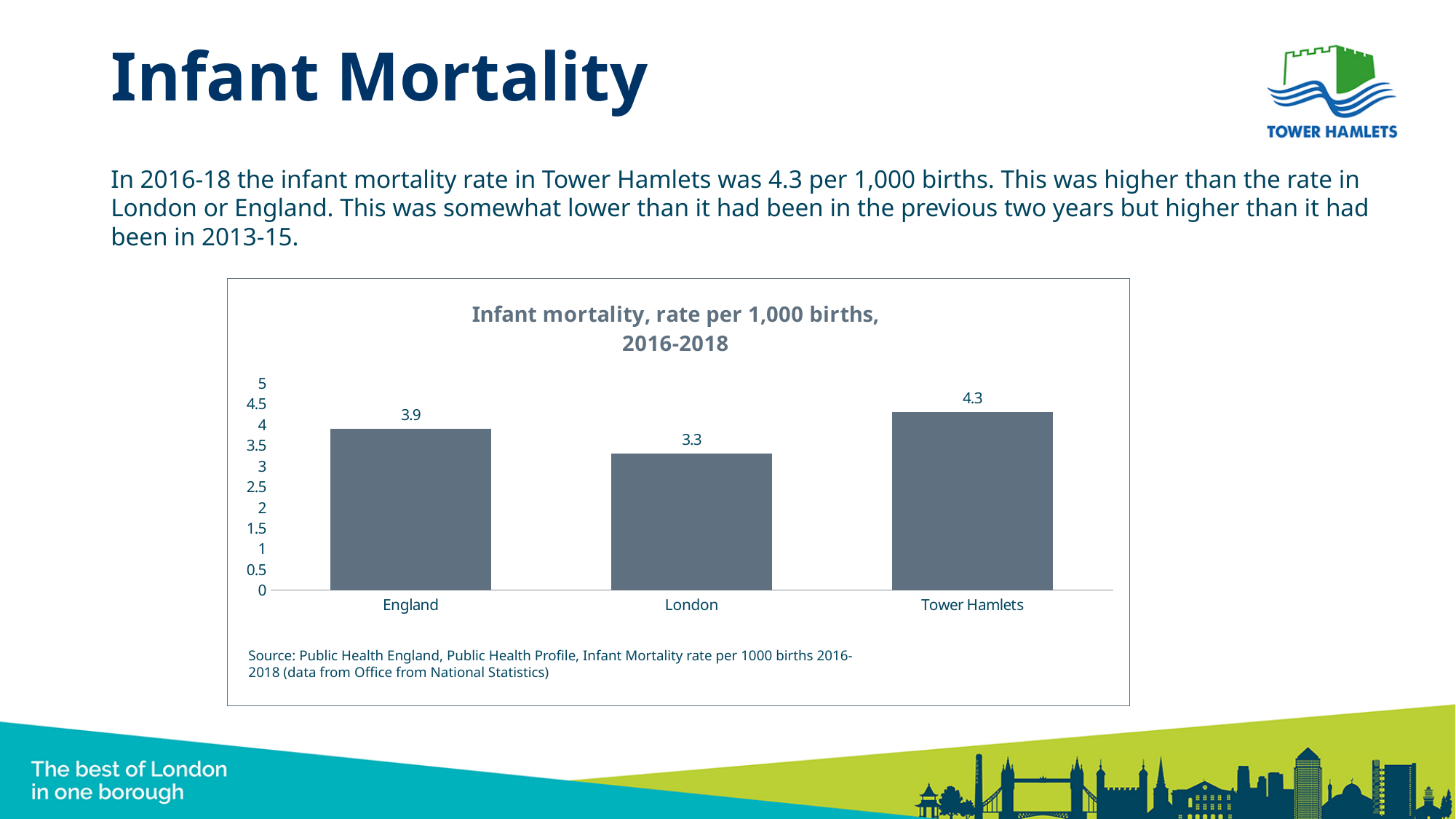
What is the infant mortality rate per 1,000 births for Tower Hamlets? 4.3 Which area has the lowest infant mortality rate in the chart? London What is the title of the chart? Infant mortality, rate per 1,000 births, 2016-2018 What kind of chart is shown on the slide? bar chart Which area has the highest infant mortality rate in the chart? Tower Hamlets What is the infant mortality rate per 1,000 births for England? 3.9 What is the infant mortality rate per 1,000 births for London? 3.3 Is the infant mortality rate for London greater or less than 3.5? less What is the difference between the infant mortality rates of Tower Hamlets and London? 1.0 How many areas are shown in the chart? 3 What is the difference between the infant mortality rates of England and London? 0.6 Which has a higher infant mortality rate, England or Tower Hamlets? Tower Hamlets